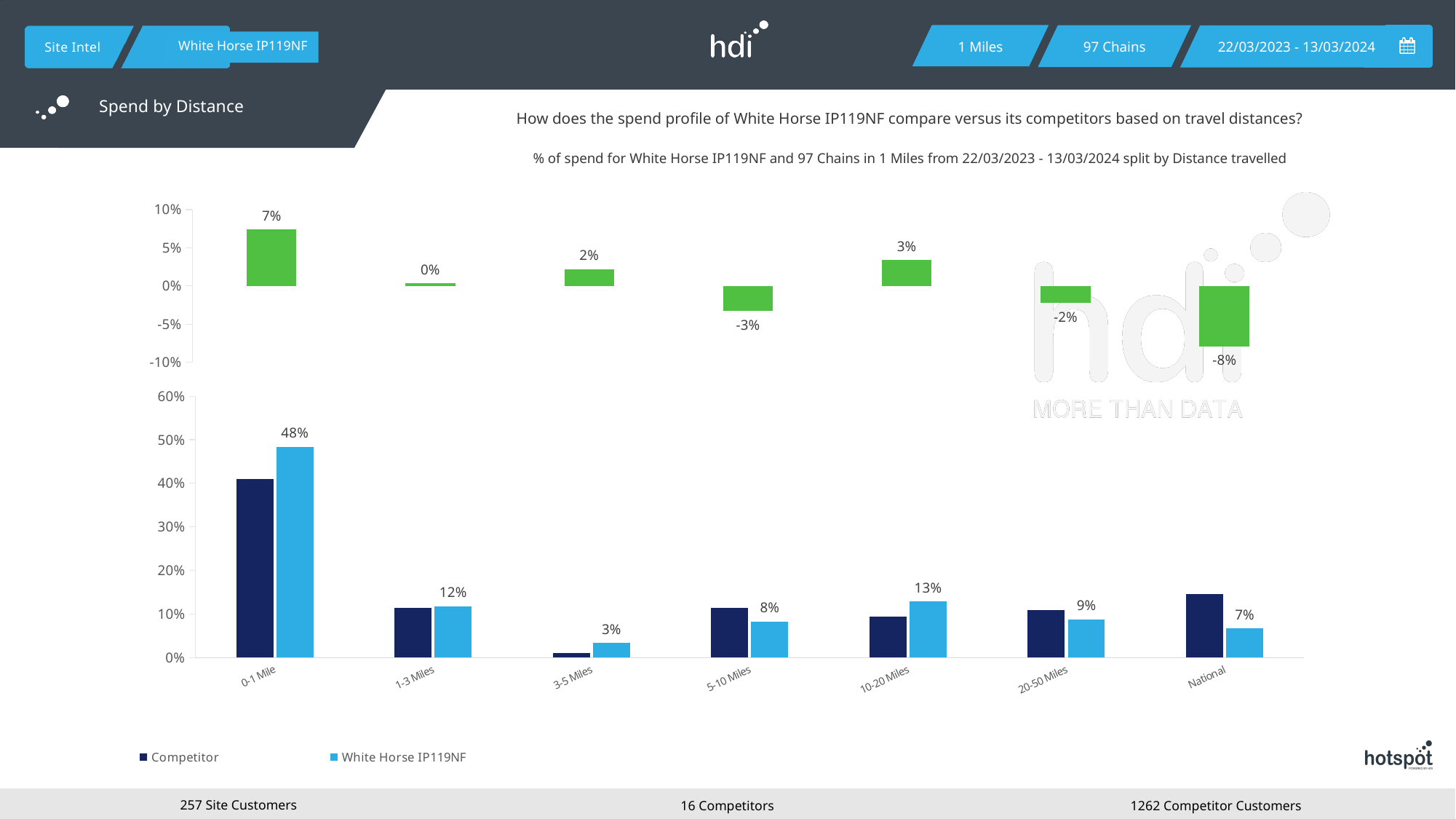
In the bottom chart, what is the value for White Horse IP119NF at 10-20 Miles? 13% How many series does the legend of the bottom chart list? 2 In the top chart, which category has the lowest value? National How many categories are shown on the x axis of the bottom chart? 7 In the bottom chart, which is larger at National: the Competitor value or the White Horse IP119NF value? Competitor In the top chart, what is the value for 5-10 Miles? -3% In the bottom chart, what is the difference between the White Horse IP119NF values for 0-1 Mile and 1-3 Miles? 36% In the bottom chart, what is the value for White Horse IP119NF at 0-1 Mile? 48% In the bottom chart, is the Competitor value for 0-1 Mile greater or less than 30%? greater In the bottom chart, which category has the highest White Horse IP119NF value? 0-1 Mile In the top chart, which category has the highest value? 0-1 Mile In the bottom chart, what is the value for White Horse IP119NF at National? 7%